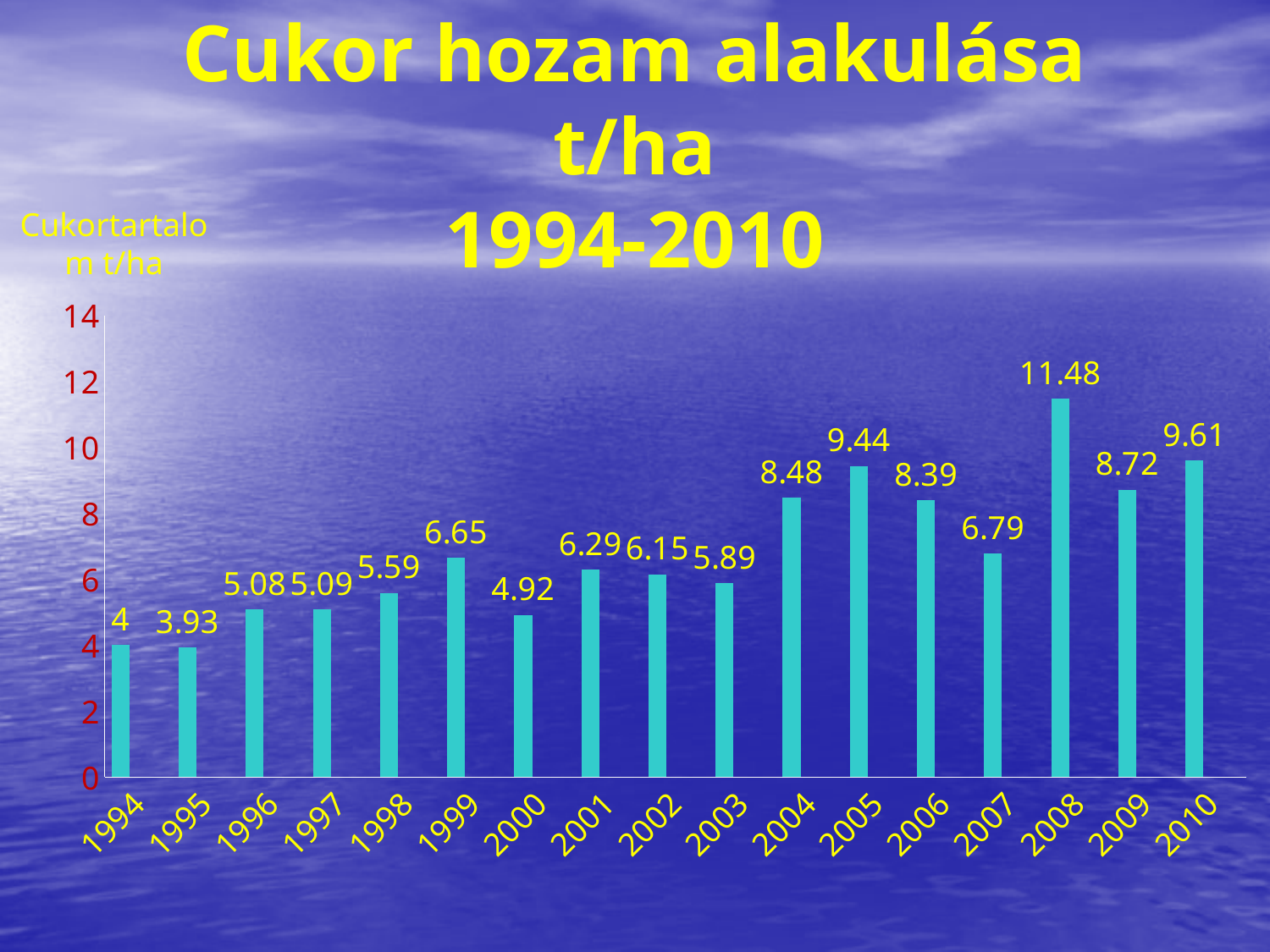
What is the title of the chart? Cukor hozam alakulása t/ha 1994-2010 Which year has the highest value? 2008 What is the value shown for 2000? 4.92 Do the values generally rise or fall from 1994 to 2010? rise How many years are shown on the x axis? 17 What type of chart is shown on the slide? bar chart What is the difference between the values for 2010 and 2009? 0.89 What is the sugar yield value for 2008? 11.48 Which year has the larger value, 2005 or 2006? 2005 What is the value shown for 1999? 6.65 Is the value for 2004 greater or less than 8? greater Which year has the lowest value? 1995